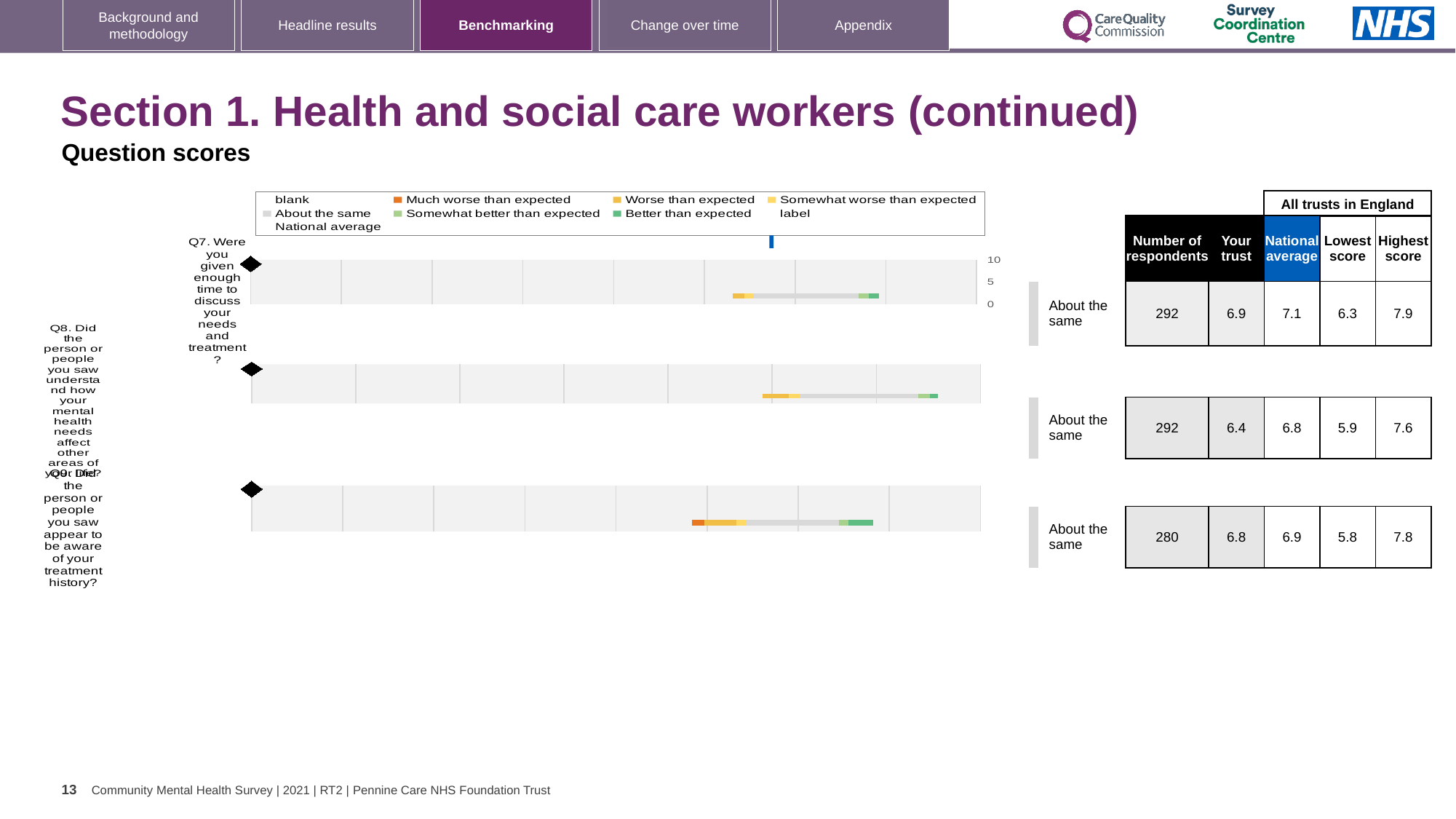
What is the national average score for Q8 (Did the person or people you saw understand how your mental health needs affect other areas of your life?)? 6.8 For Q7, what is the difference between the national average and the 'Your trust' score? 0.2 How many respondents are shown for Q9 (Did the person or people you saw appear to be aware of your treatment history?)? 280 What is the highest score across all trusts in England for Q7? 7.9 Which question has the highest 'Your trust' score on this slide? Q7 How many questions are charted on this slide? 3 What benchmark category is shown for Q8? About the same Is the 'Your trust' score for Q7 greater or less than 5? greater What is the 'Your trust' score for Q7 (Were you given enough time to discuss your needs and treatment?)? 6.9 What is the lowest score across all trusts in England for Q8? 5.9 What kind of chart is used to show the question scores? Bar chart For Q9, which is larger: the 'Your trust' score or the national average? National average